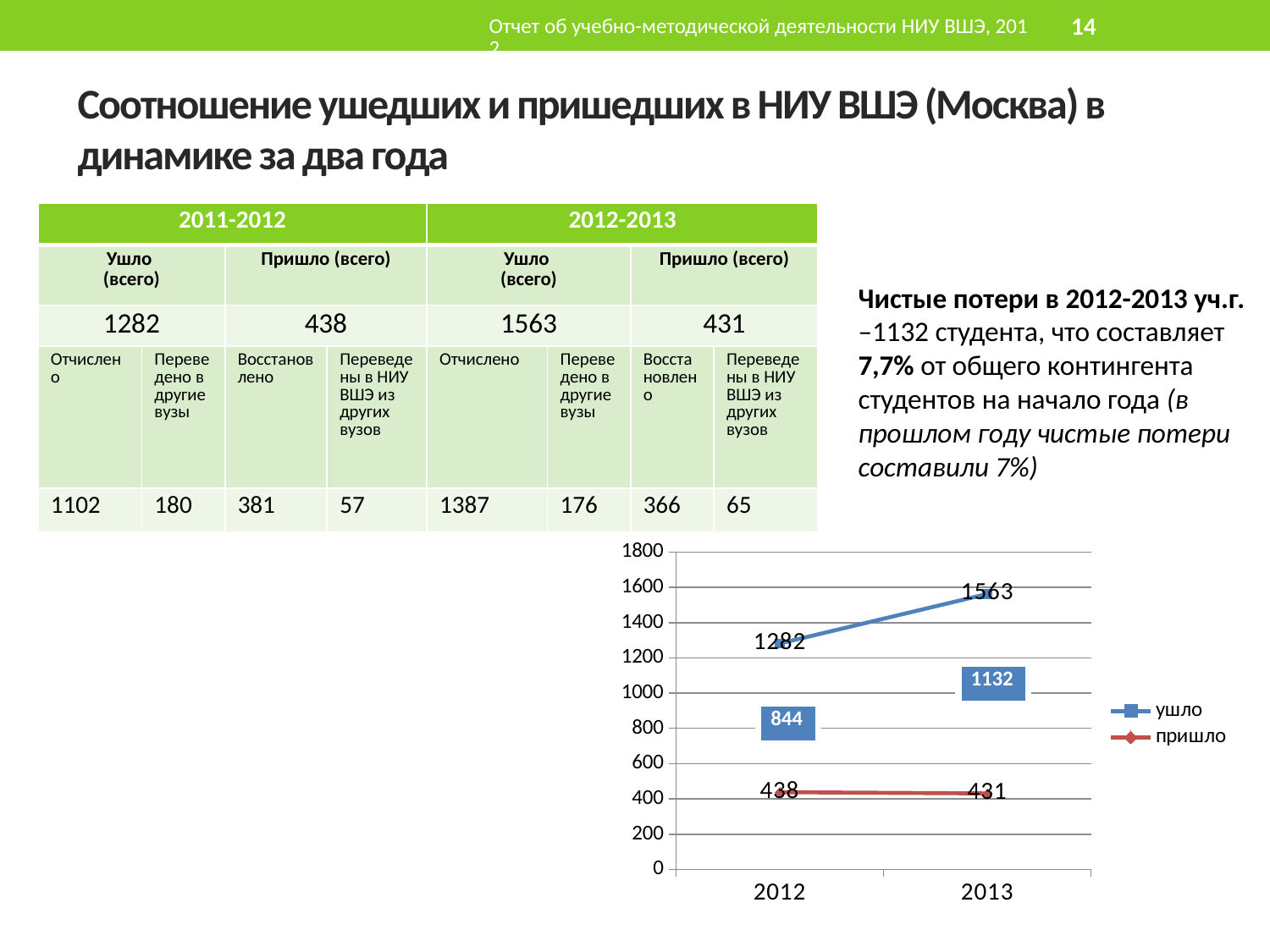
How many points are plotted along the x axis of the chart? 2 What are the two series named in the chart legend? ушло, пришло How many series does the chart legend list? 2 What is the value of the 'пришло' series for 2012? 438 Does the 'ушло' series rise or fall from 2012 to 2013? rise By how much did the 'ушло' value increase from 2012 to 2013? 281 What is the value of the 'пришло' series for 2013? 431 What kind of chart is shown on the slide? line chart Which series has the larger value in 2013, 'ушло' or 'пришло'? ушло What is the value of the 'ушло' series for 2012? 1282 What is the value of the 'ушло' series for 2013? 1563 What is the difference between the 'ушло' and 'пришло' values in 2012? 844